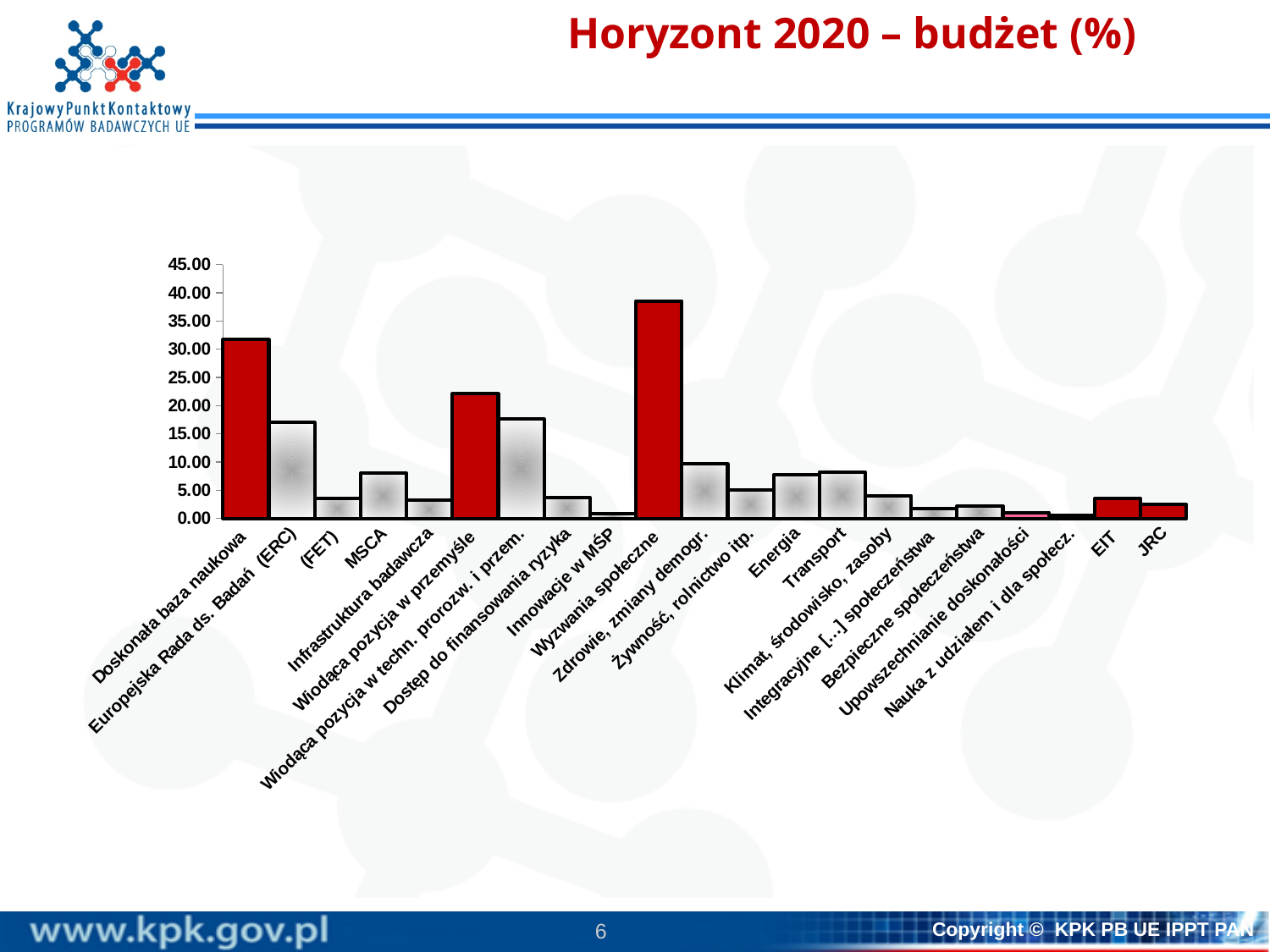
What is the highest value shown on the y axis of the chart? 45.00 Which category has the highest value in the chart? Wyzwania społeczne Which is larger, the value for Europejska Rada ds. Badań (ERC) or the value for MSCA? Europejska Rada ds. Badań (ERC) Is the value for Europejska Rada ds. Badań (ERC) greater or less than 20.00? less Is the value for Wyzwania społeczne greater or less than 35.00? greater How many categories are shown on the x axis of the chart? 21 Is the value for MSCA greater or less than 10.00? less Which is larger, the value for Doskonała baza naukowa or the value for Wiodąca pozycja w przemyśle? Doskonała baza naukowa What kind of chart is shown on the slide? bar chart What is the title of the chart on the slide? Horyzont 2020 – budżet (%)